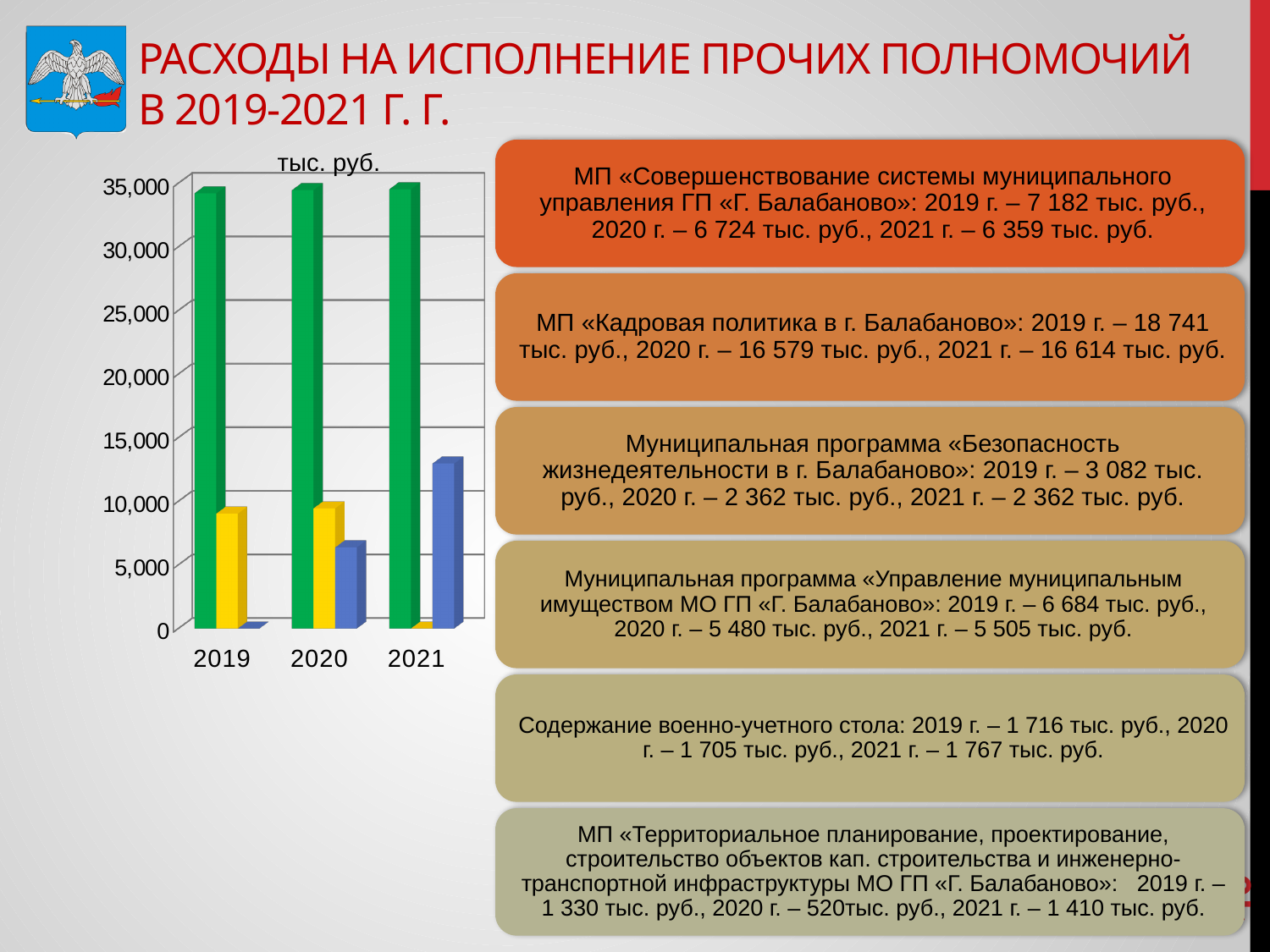
Is the value of the blue bar for 2020 greater or less than 5,000? greater What kind of chart is shown on the slide? bar chart Which is larger in 2021: the green bar or the blue bar? the green bar Is the value of the blue bar for 2021 greater or less than 10,000? greater Is the value of the green bar for 2019 greater or less than 30,000? greater Do the values of the blue bars rise or fall from 2019 to 2021? rise In which year is the blue bar the highest? 2021 How many year categories are shown on the x axis of the chart? 3 Which is larger in 2020: the yellow bar or the blue bar? the yellow bar What is the title shown above the chart? тыс. руб.